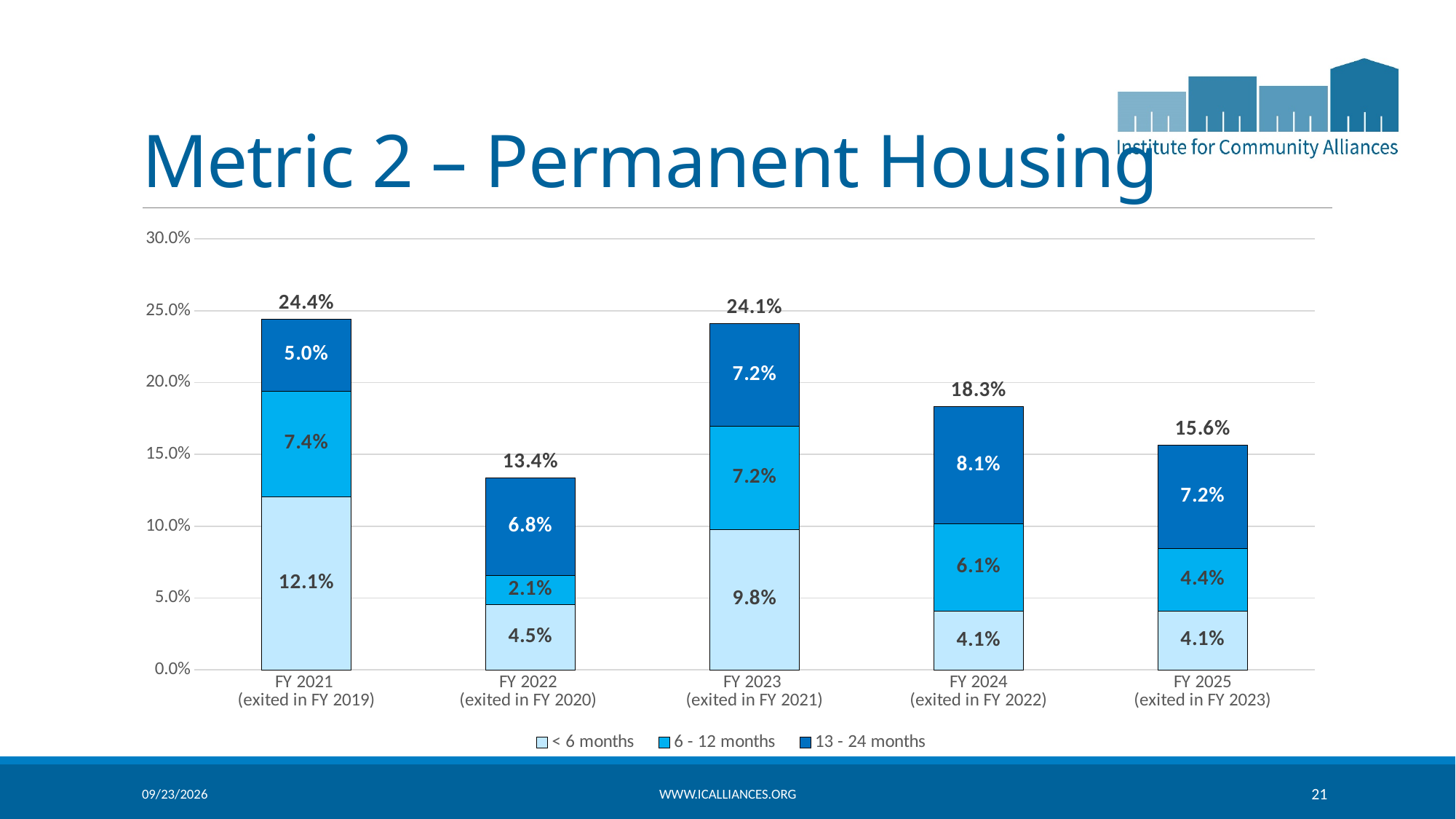
How many series does the legend list? 3 Which fiscal year has the highest stacked bar total? FY 2021 What is the value of the '6 - 12 months' segment for FY 2022? 2.1% What kind of chart is shown on the slide? Stacked bar chart What is the value of the '13 - 24 months' segment for FY 2024? 8.1% Which fiscal year has the lowest stacked bar total? FY 2022 What is the total of the stacked bar for FY 2023? 24.1% Which is larger, the '6 - 12 months' segment for FY 2024 or for FY 2025? FY 2024 What is the value of the '< 6 months' segment for FY 2021? 12.1% Is the stacked bar total for FY 2024 greater or less than 20.0%? less What is the difference between the stacked bar totals for FY 2021 and FY 2025? 8.8% How many fiscal years are shown on the x axis? 5